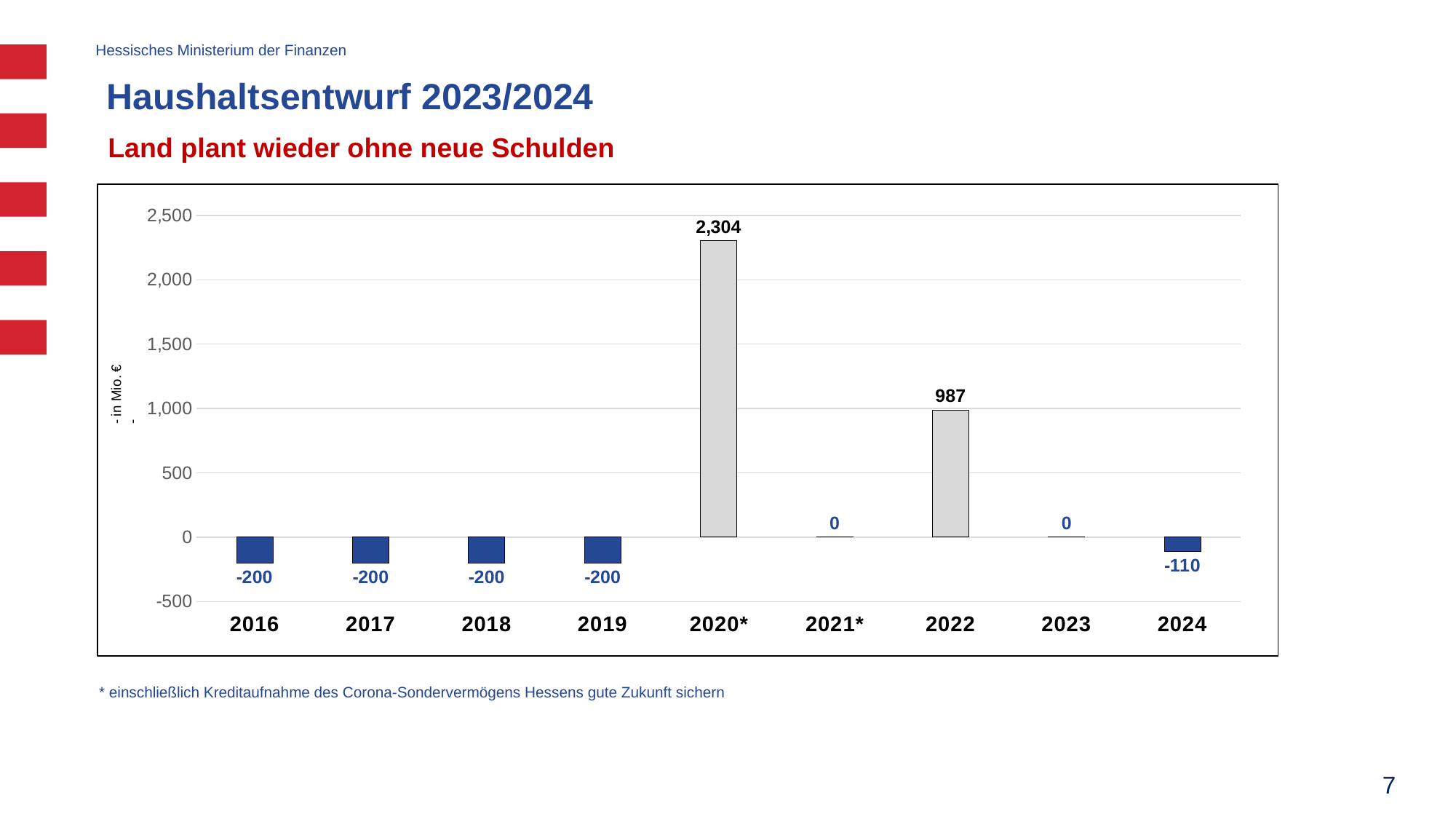
What unit is given on the y axis label? in Mio. € Which year has the highest value? 2020* What is the difference between the values for 2024 and 2019? 90 What is the value for 2022? 987 What is the value for 2023? 0 What is the value for 2024? -110 What is the value for 2020*? 2,304 How many years are shown on the x axis? 9 What is the value for 2016? -200 What is the difference between the values for 2020* and 2022? 1,317 Which is larger, the value for 2022 or the value for 2020*? 2020* What kind of chart is shown on the slide? bar chart